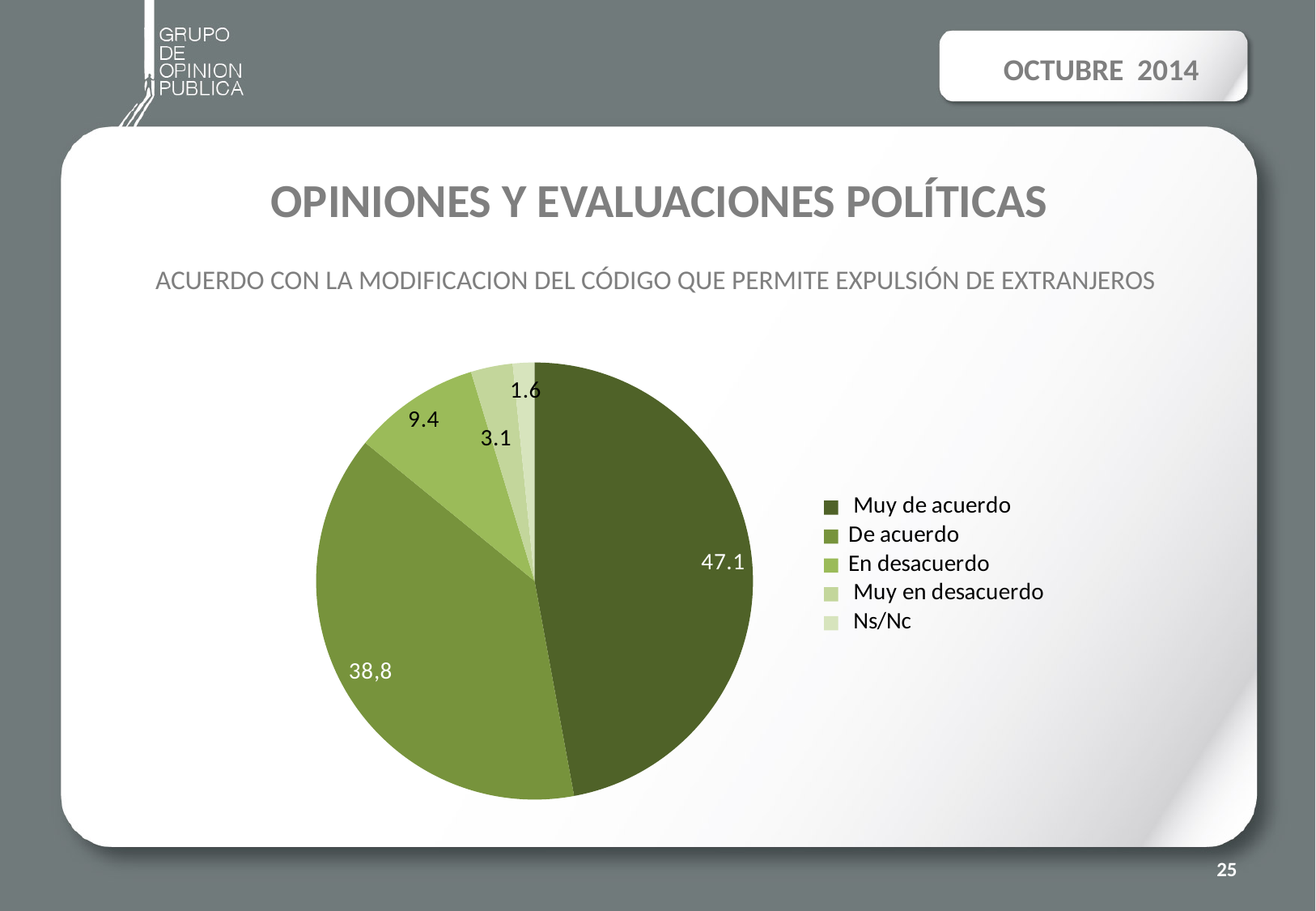
What is the value for "En desacuerdo"? 9.4 What kind of chart is shown on the slide? pie chart What is the difference between the values for "Muy de acuerdo" and "De acuerdo"? 8.3 Which category has the smallest slice of the pie? Ns/Nc What is the value for "Muy en desacuerdo"? 3.1 What is the value for "Muy de acuerdo"? 47.1 What is the value for "Ns/Nc"? 1.6 Which category has the largest slice of the pie? Muy de acuerdo How many categories does the legend list? 5 Which is larger, the value for "En desacuerdo" or the value for "Muy en desacuerdo"? En desacuerdo What is the subtitle printed above the pie chart? ACUERDO CON LA MODIFICACION DEL CÓDIGO QUE PERMITE EXPULSIÓN DE EXTRANJEROS What is the value for "De acuerdo"? 38,8